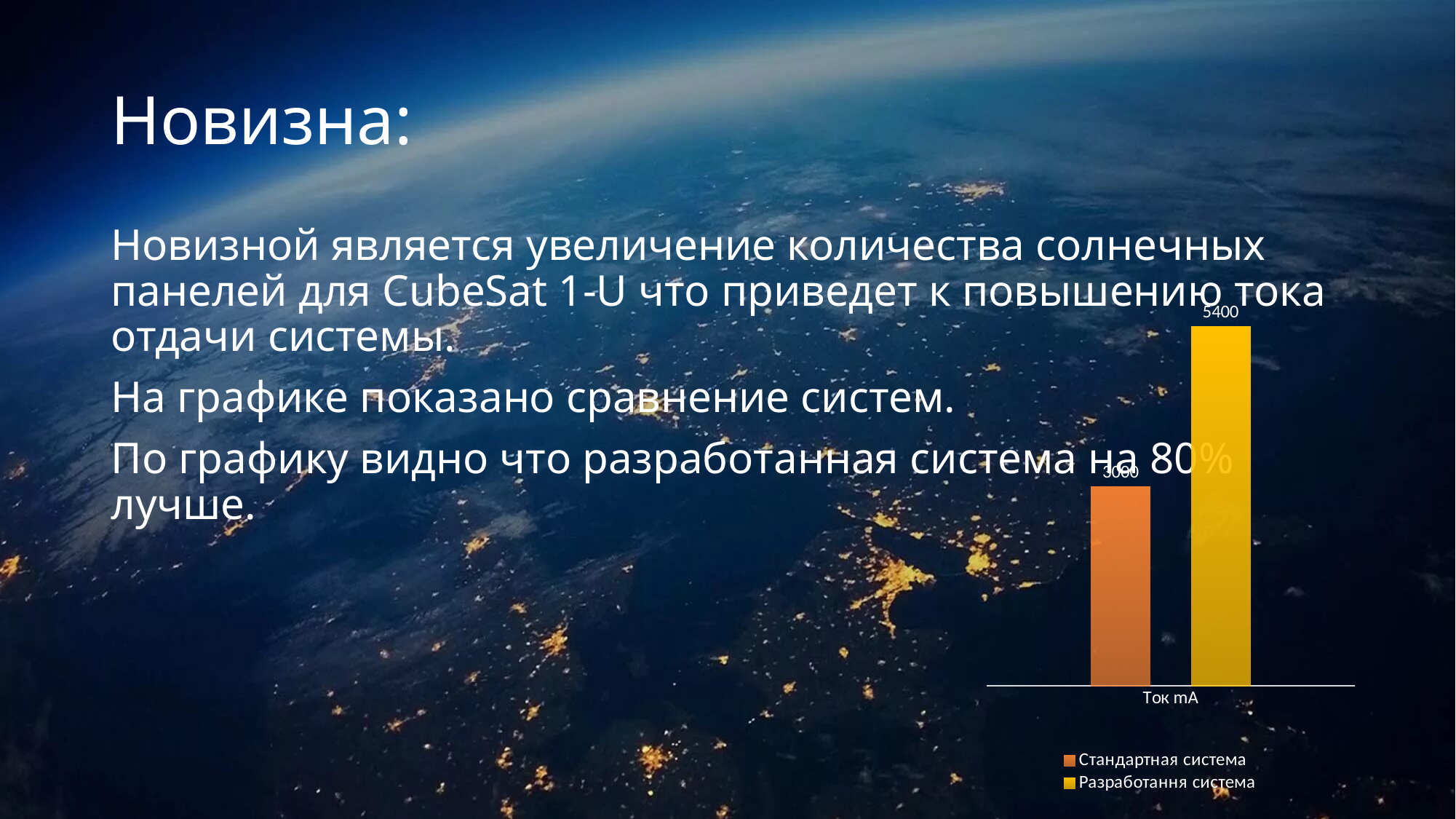
What kind of chart is shown on the slide? bar chart Which series has the lower value in the chart? Стандартная система What is the label on the category axis of the chart? Ток mA What value is shown for Разработання система in the chart? 5400 What is the difference between the values for Разработання система and Стандартная система? 2400 How many series does the chart legend list? 2 What colour is the bar for Разработання система? yellow Is the value for Стандартная система larger or smaller than the value for Разработання система? smaller How many bars are plotted in the chart? 2 What value is shown for Стандартная система in the chart? 3000 Which series has the higher value in the chart? Разработання система